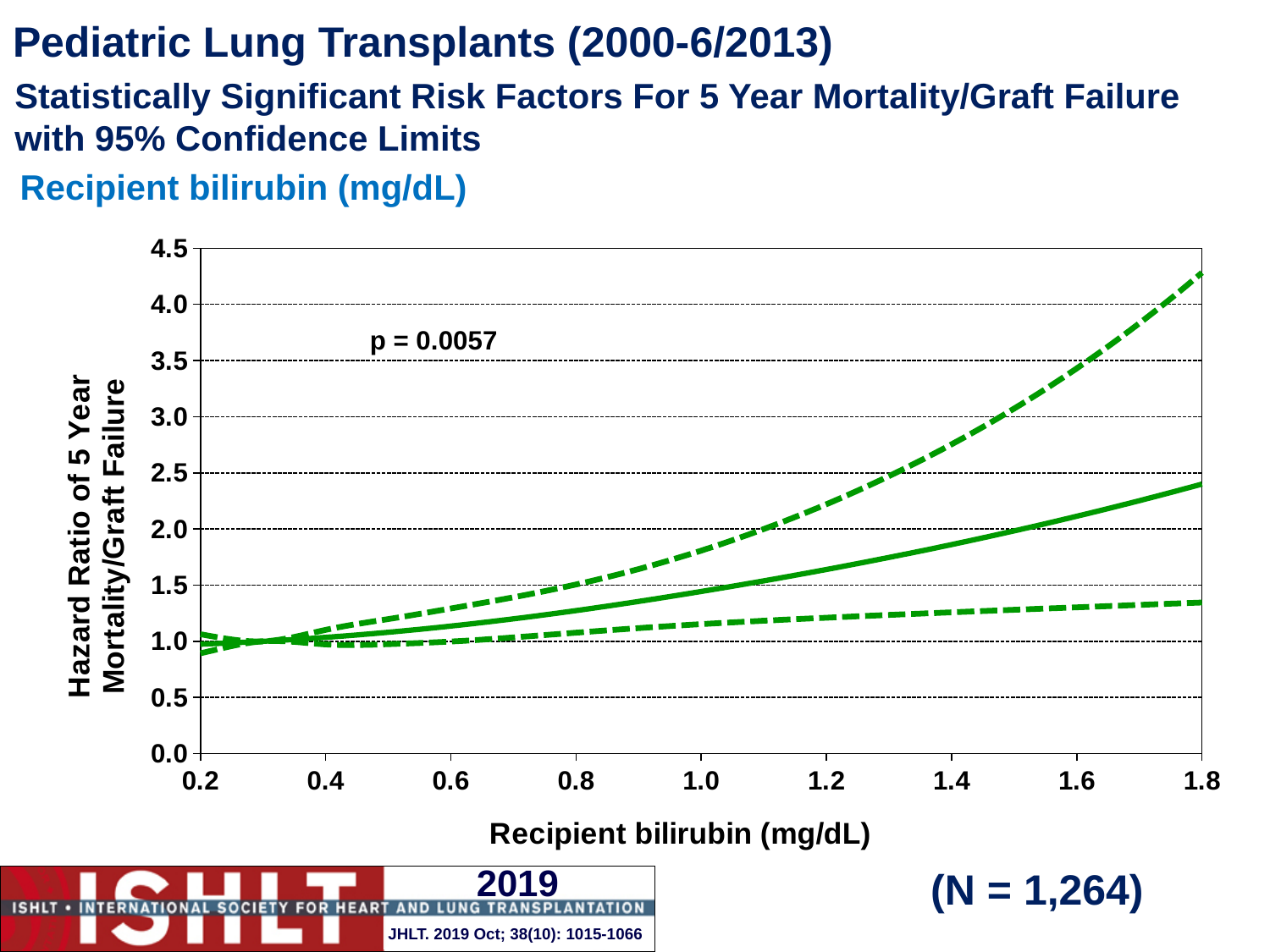
Does the solid hazard ratio line rise or fall as recipient bilirubin increases along the x axis? rise What kind of chart is shown on the slide? line chart What p-value is printed on the chart? p = 0.0057 Is the value of the upper dashed confidence limit at a recipient bilirubin of 1.8 mg/dL greater or less than 4.0? greater How many lines are plotted on the chart? 3 What is the highest value shown on the y axis? 4.5 What is the label of the x axis? Recipient bilirubin (mg/dL) Is the value of the lower dashed confidence limit at a recipient bilirubin of 1.8 mg/dL greater or less than 1.5? less At a recipient bilirubin of 1.8 mg/dL, which is larger: the upper dashed confidence limit or the solid hazard ratio line? the upper dashed confidence limit What is the lowest recipient bilirubin value shown on the x axis? 0.2 Is the value of the solid hazard ratio line at a recipient bilirubin of 1.4 mg/dL greater or less than 1.5? greater